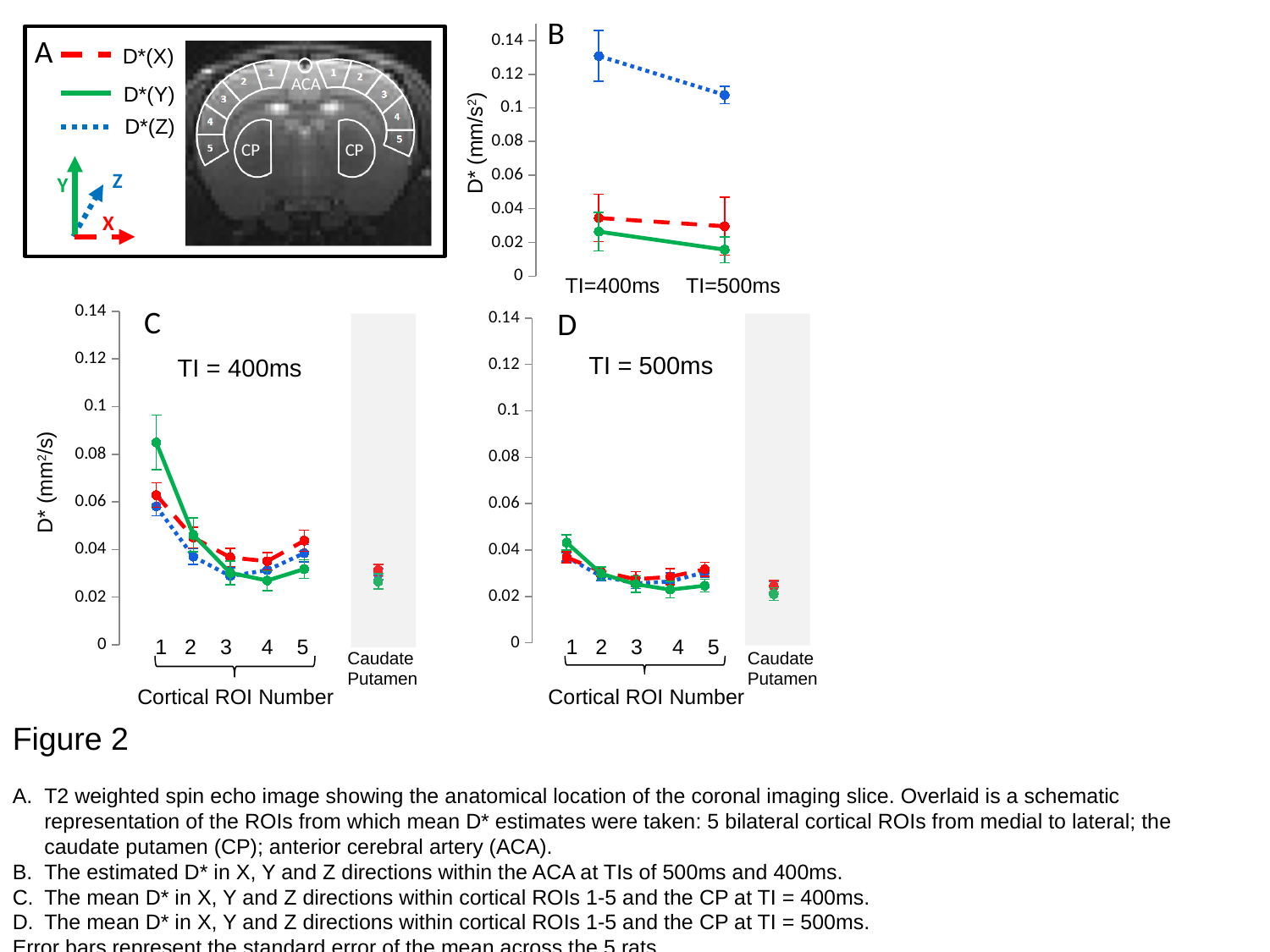
How many series does the legend in panel A list? 3 What kind of chart is chart C? line chart In chart C (TI = 400ms), is the value of D*(Y) at cortical ROI 1 greater or less than 0.08? greater In chart D (TI = 500ms), how many cortical ROI numbers are plotted on the x axis? 5 In chart B, is the value of D*(Z) at TI=500ms greater or less than 0.12? less In chart D (TI = 500ms), is the value of D*(Y) at cortical ROI 1 greater or less than 0.06? less In chart B, how many TI categories are shown on the x axis? 2 In chart C (TI = 400ms), which cortical ROI number has the highest D*(Y) value? 1 In chart B, which series has the highest values at both TI=400ms and TI=500ms? D*(Z) In chart B, do the D*(Z) values rise or fall from TI=400ms to TI=500ms? fall In chart C (TI = 400ms), is the D*(Y) value at cortical ROI 1 larger or smaller than the D*(Y) value at cortical ROI 4? larger